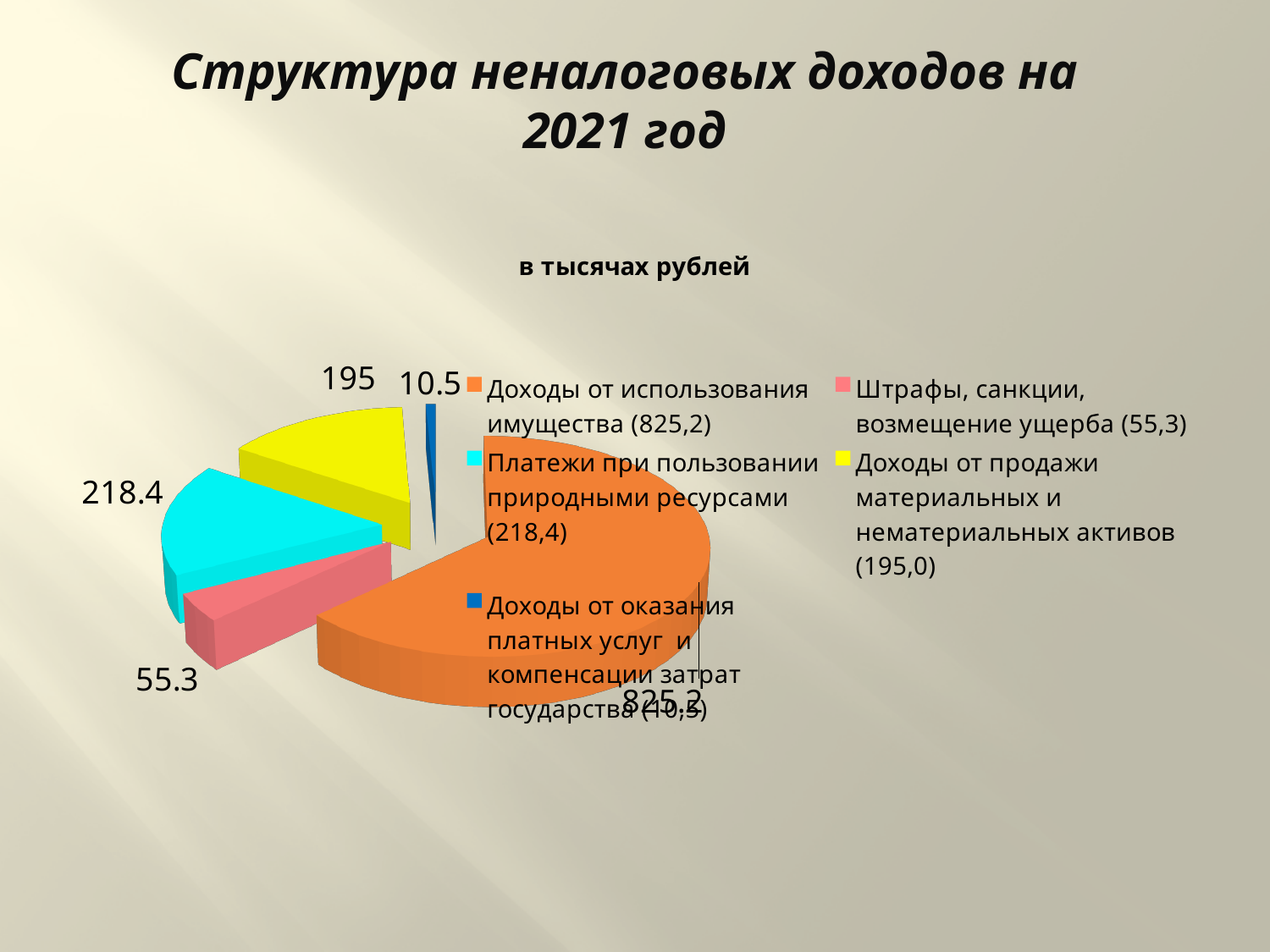
What is the difference between the values for "Доходы от использования имущества" and "Платежи при пользовании природными ресурсами"? 606.8 What is the value of the slice for "Платежи при пользовании природными ресурсами"? 218.4 Which is larger: the slice for "Платежи при пользовании природными ресурсами" or the slice for "Доходы от продажи материальных и нематериальных активов"? Платежи при пользовании природными ресурсами What unit of measurement is stated above the chart? в тысячах рублей How many slices does the pie chart have? 5 Which category has the largest slice of the pie? Доходы от использования имущества What is the value of the slice for "Доходы от продажи материальных и нематериальных активов"? 195 What kind of chart is shown on the slide? Pie chart What colour is the slice for "Штрафы, санкции, возмещение ущерба"? Pink What is the value of the slice for "Штрафы, санкции, возмещение ущерба"? 55.3 Which category has the smallest slice of the pie? Доходы от оказания платных услуг и компенсации затрат государства What is the value of the slice for "Доходы от использования имущества"? 825.2